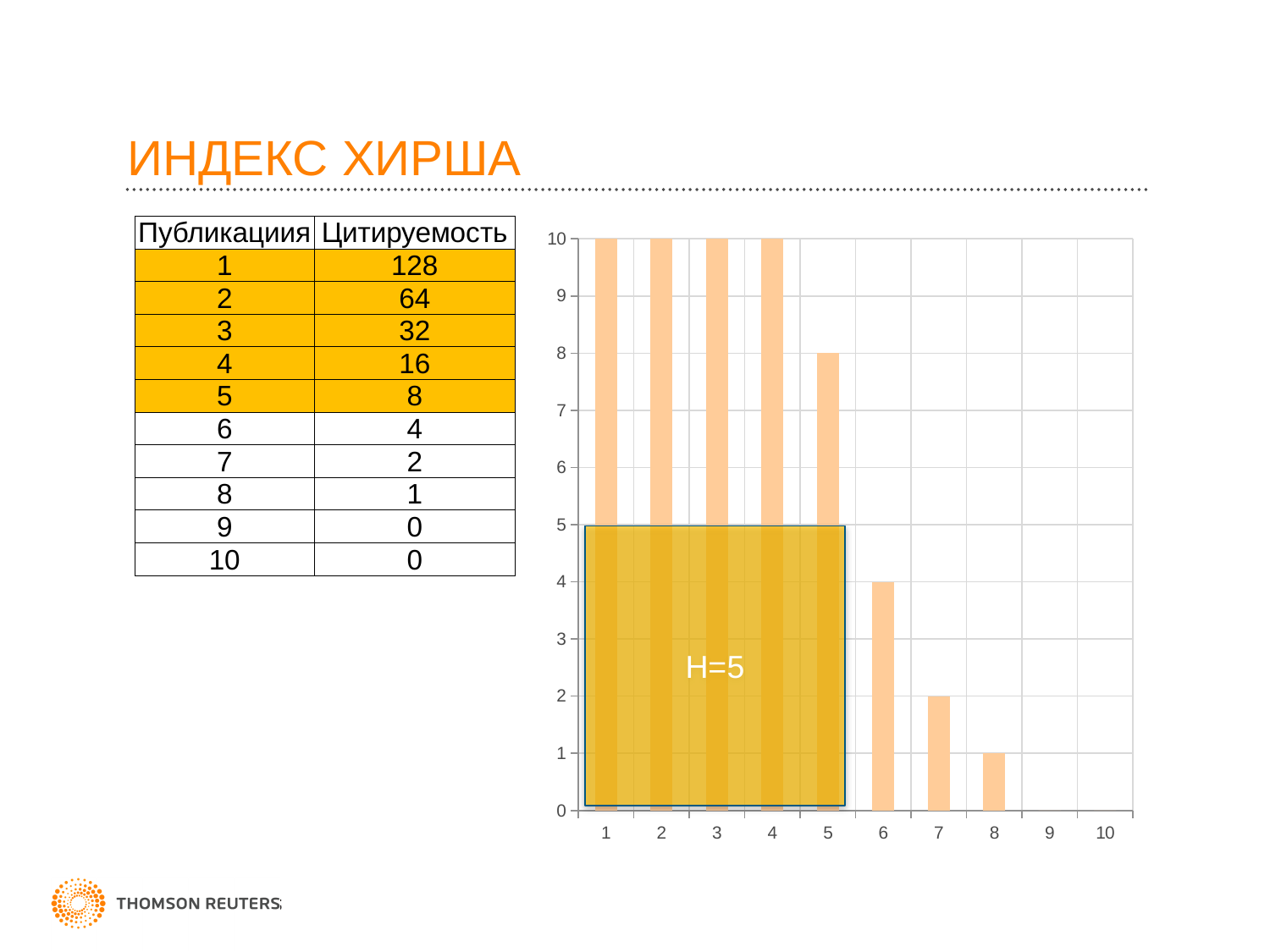
What is the value of the bar for category 7? 2 What is the value of the bar for category 8? 1 What is the value of the bar for category 5? 8 Do the bar values rise or fall as you move from category 1 to category 10? fall How many categories are shown on the x axis of the chart? 10 What is the value of the bar for category 6? 4 What is the difference between the bar for category 5 and the bar for category 6? 4 What text is written inside the highlighted square on the chart? H=5 What kind of chart is shown on the slide? bar chart Is the value for category 7 greater or less than 3? less Which is larger, the bar for category 5 or the bar for category 6? category 5 Is the value for category 5 greater or less than 6? greater